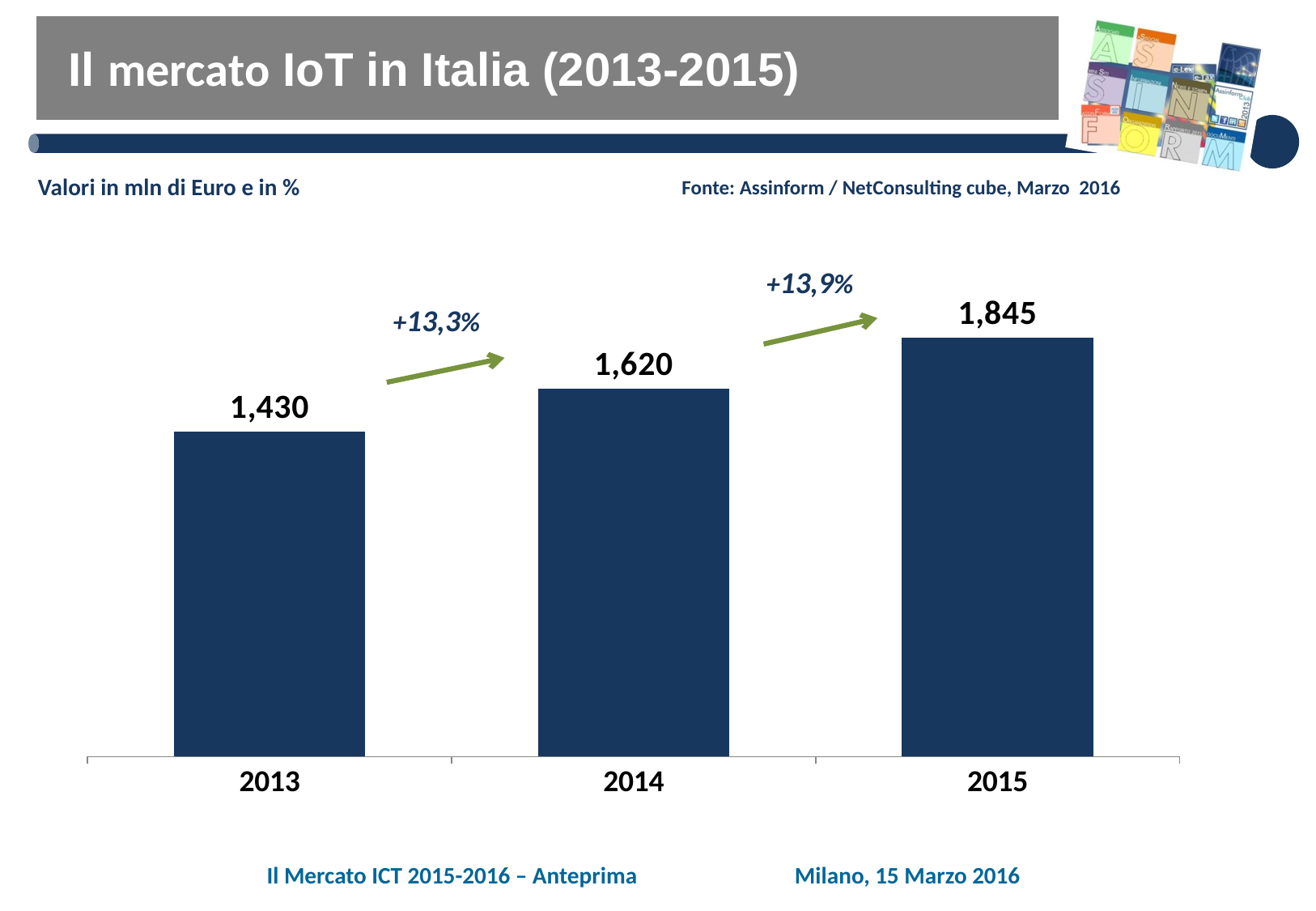
Which is larger, the value for 2013 or the value for 2015? 2015 What is the difference between the values for 2015 and 2014? 225 Which year has the lowest value? 2013 What percentage growth is shown between 2014 and 2015? +13,9% What is the value for 2014? 1,620 How many years are shown on the x axis? 3 What is the difference between the values for 2014 and 2013? 190 Which year has the highest value? 2015 What kind of chart is shown on the slide? bar chart What is the value for 2015? 1,845 What is the value for 2013? 1,430 Do the values rise or fall from 2013 to 2015? rise